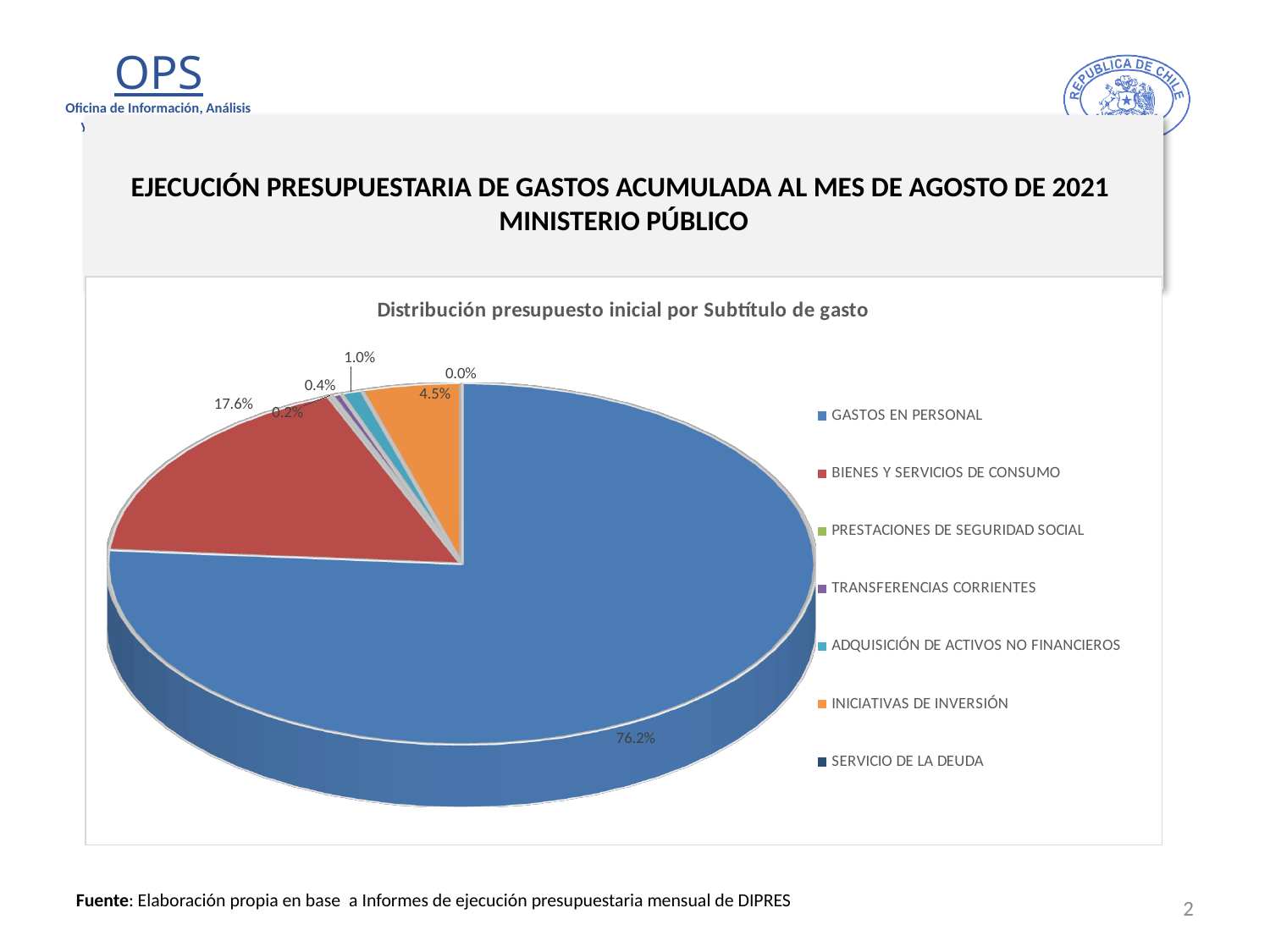
How many categories does the legend of the pie chart list? 7 What share of the pie does BIENES Y SERVICIOS DE CONSUMO represent? 17.6% What share of the pie does GASTOS EN PERSONAL represent? 76.2% What share of the pie does ADQUISICIÓN DE ACTIVOS NO FINANCIEROS represent? 1.0% Which category has the largest share of the pie? GASTOS EN PERSONAL Which is larger, the share for BIENES Y SERVICIOS DE CONSUMO or the share for INICIATIVAS DE INVERSIÓN? BIENES Y SERVICIOS DE CONSUMO What is the title of the chart? Distribución presupuesto inicial por Subtítulo de gasto Which colour represents GASTOS EN PERSONAL in the pie chart? Blue What is the difference between the share for GASTOS EN PERSONAL and the share for BIENES Y SERVICIOS DE CONSUMO? 58.6% What kind of chart is shown on the slide? Pie chart